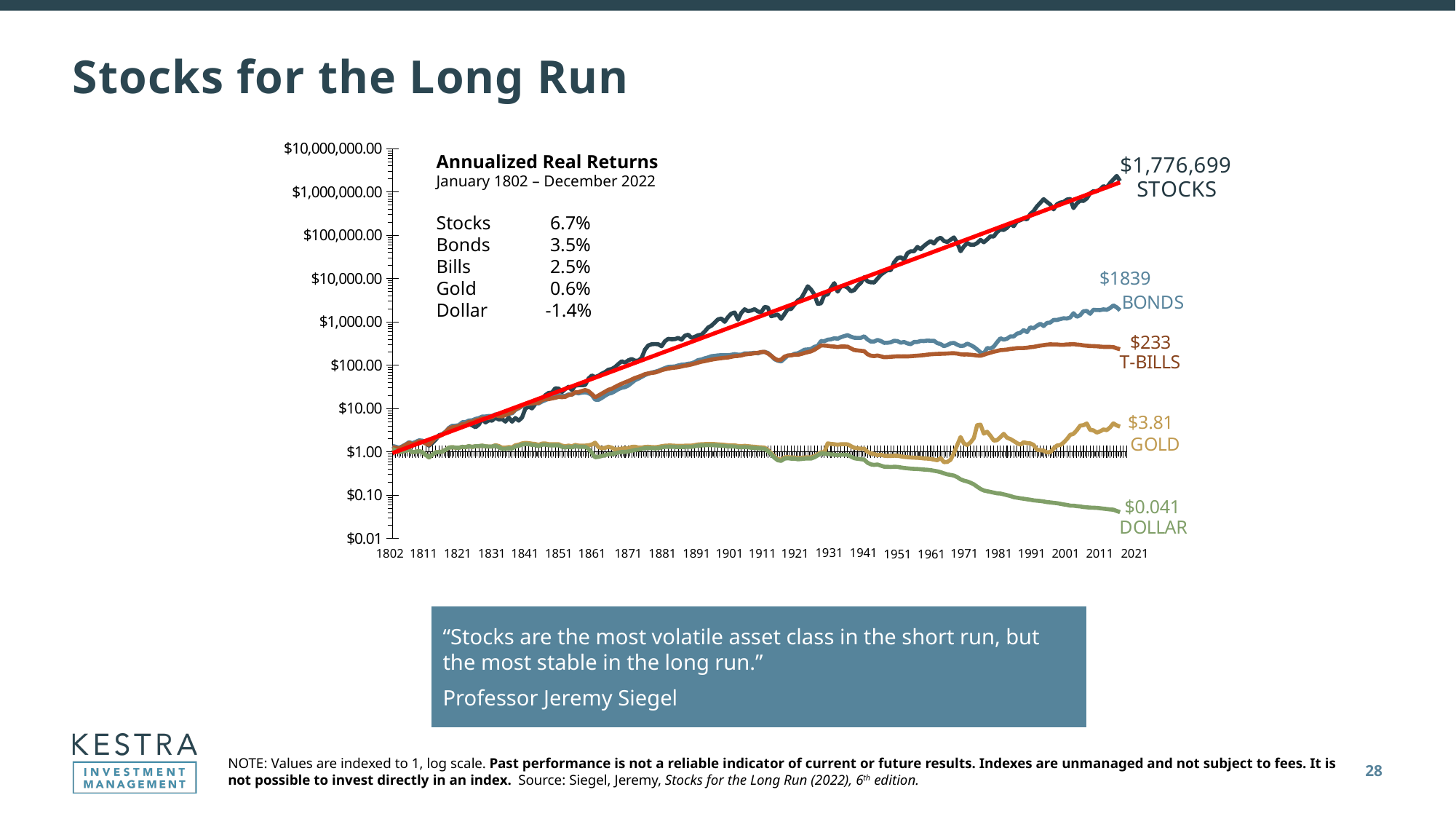
What is the ending value shown for DOLLAR? $0.041 Which has a larger ending value, GOLD or T-BILLS? T-BILLS What is the ending value shown for T-BILLS? $233 Is the value of the DOLLAR line in 2001 greater or less than $0.10? less What annualized real return is listed for Stocks in the chart's text box? 6.7% Does the DOLLAR line rise or fall from 1802 to 2021? fall Which asset class has the highest ending value on the chart? STOCKS What is the difference between the ending values of BONDS and T-BILLS? $1606 What is the ending value shown for STOCKS at the right end of the chart? $1,776,699 What is the ending value shown for GOLD? $3.81 What is the ending value shown for BONDS? $1839 Which asset class has the lowest ending value on the chart? DOLLAR